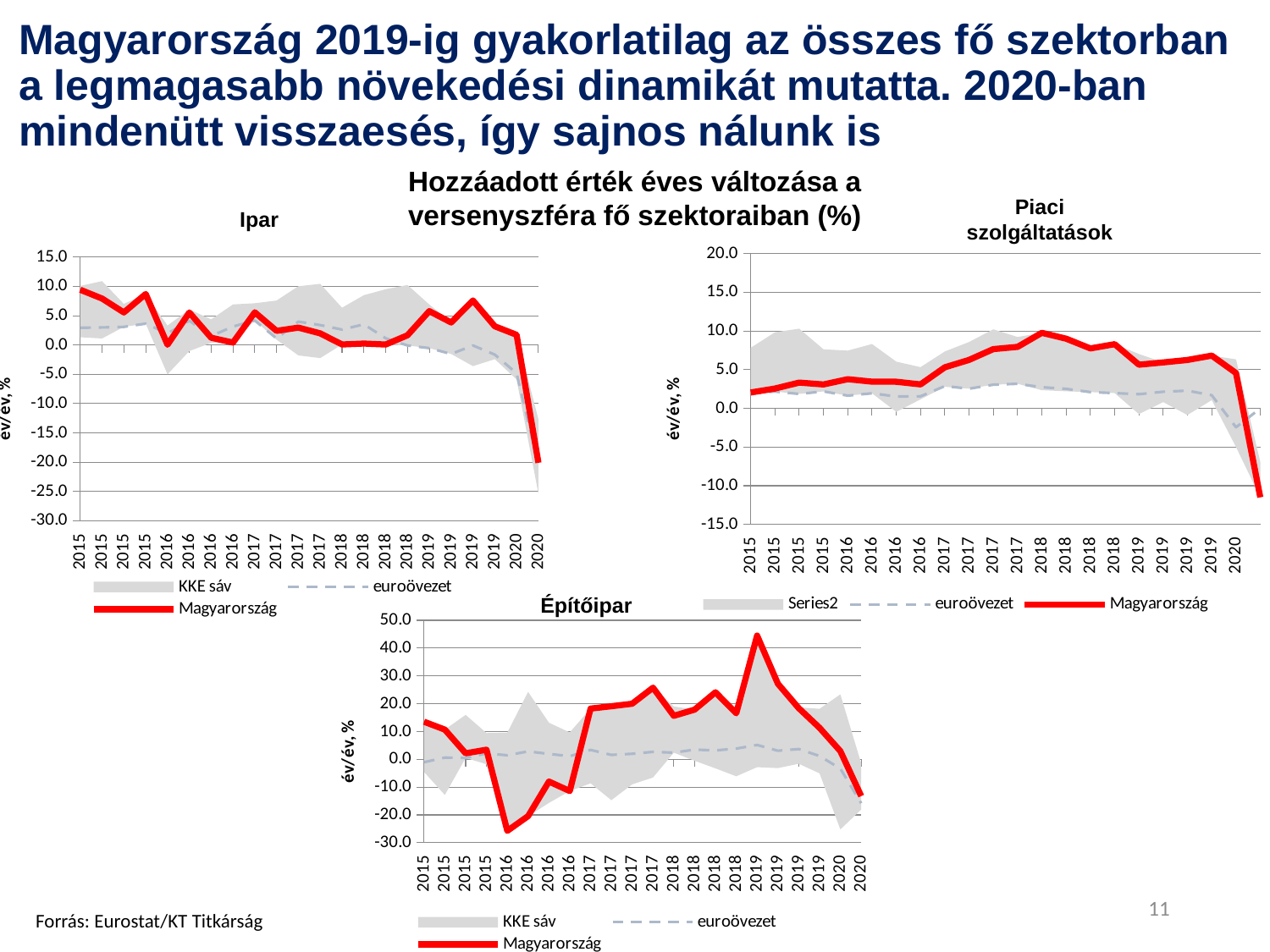
In the 'Piaci szolgáltatások' chart, in which year does the Magyarország line reach its highest value? 2018 In the 'Építőipar' chart, at the 2019 peak, which is larger: Magyarország or euroövezet? Magyarország How many charts are shown on the slide? 3 In the 'Piaci szolgáltatások' chart, what are the three legend entries? Series2, euroövezet, Magyarország In the 'Piaci szolgáltatások' chart, is the final 2020 value of Magyarország greater or less than -5.0? less How many series does the legend of the 'Ipar' chart list? 3 What is the overall title shown above the charts? Hozzáadott érték éves változása a versenyszféra fő szektoraiban (%) What kind of chart is the 'Ipar' chart? combination area and line chart In the 'Építőipar' chart, is the lowest value of Magyarország in 2016 greater or less than -20.0? less In the 'Építőipar' chart, is the peak value of Magyarország in 2019 greater or less than 40.0? greater In the 'Ipar' chart, in which year does the Magyarország line reach its lowest value? 2020